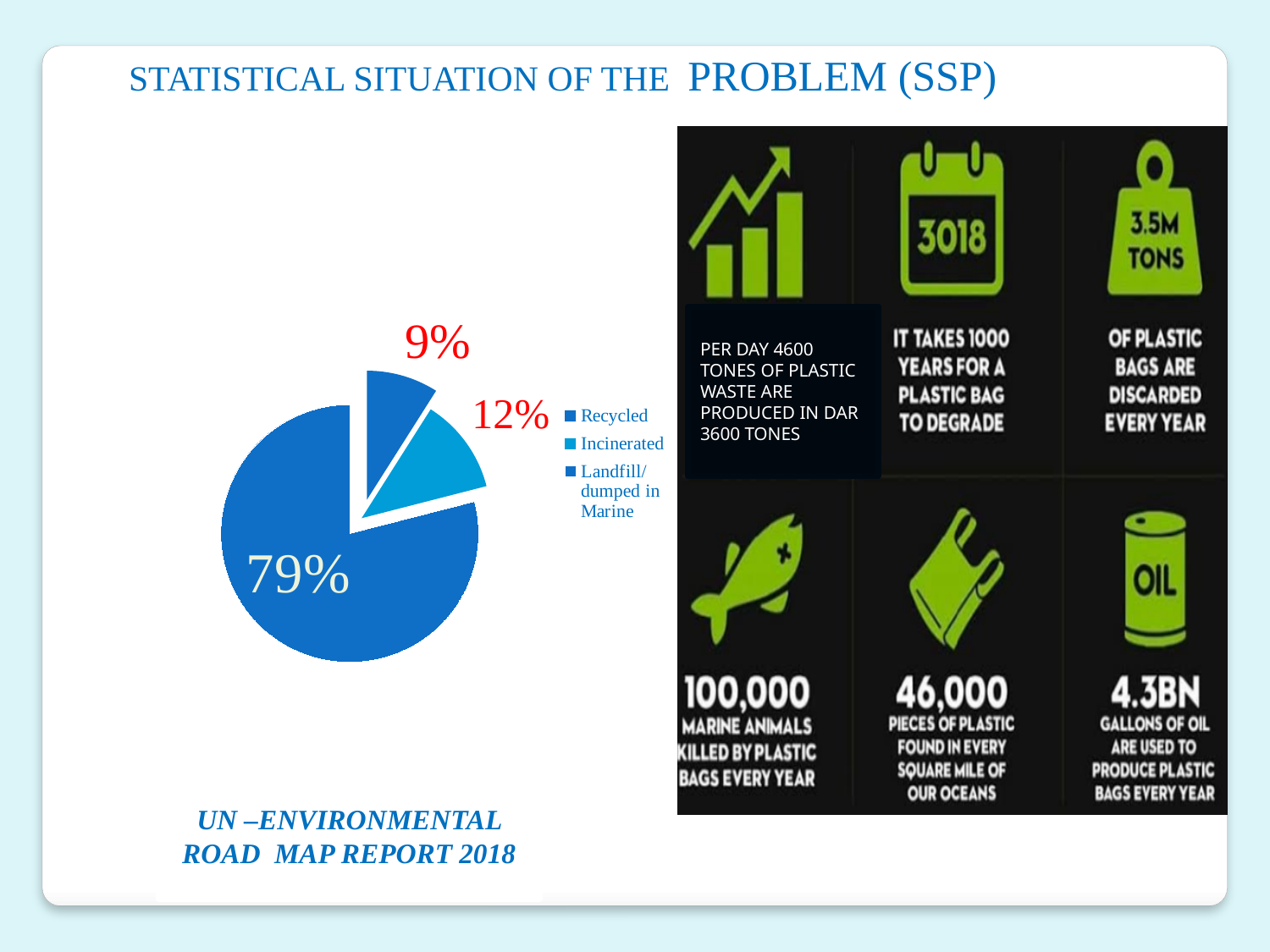
What is the difference in percentage points between the Incinerated slice and the Recycled slice? 3 Which category has the smallest share of the pie chart? Recycled Which legend entry is listed first in the pie chart legend? Recycled Which category has the largest share of the pie chart? Landfill/dumped in Marine Which is larger in the pie chart, Incinerated or Recycled? Incinerated What percentage of the pie chart is labelled Incinerated? 12% What kind of chart is shown on the left of the slide? Pie chart How many slices does the pie chart have? 3 What percentage of the pie chart is labelled Recycled? 9% What percentage of the pie chart is for Landfill/dumped in Marine? 79% What is the difference in percentage points between the Landfill/dumped in Marine slice and the Incinerated slice? 67 How many entries does the pie chart legend list? 3